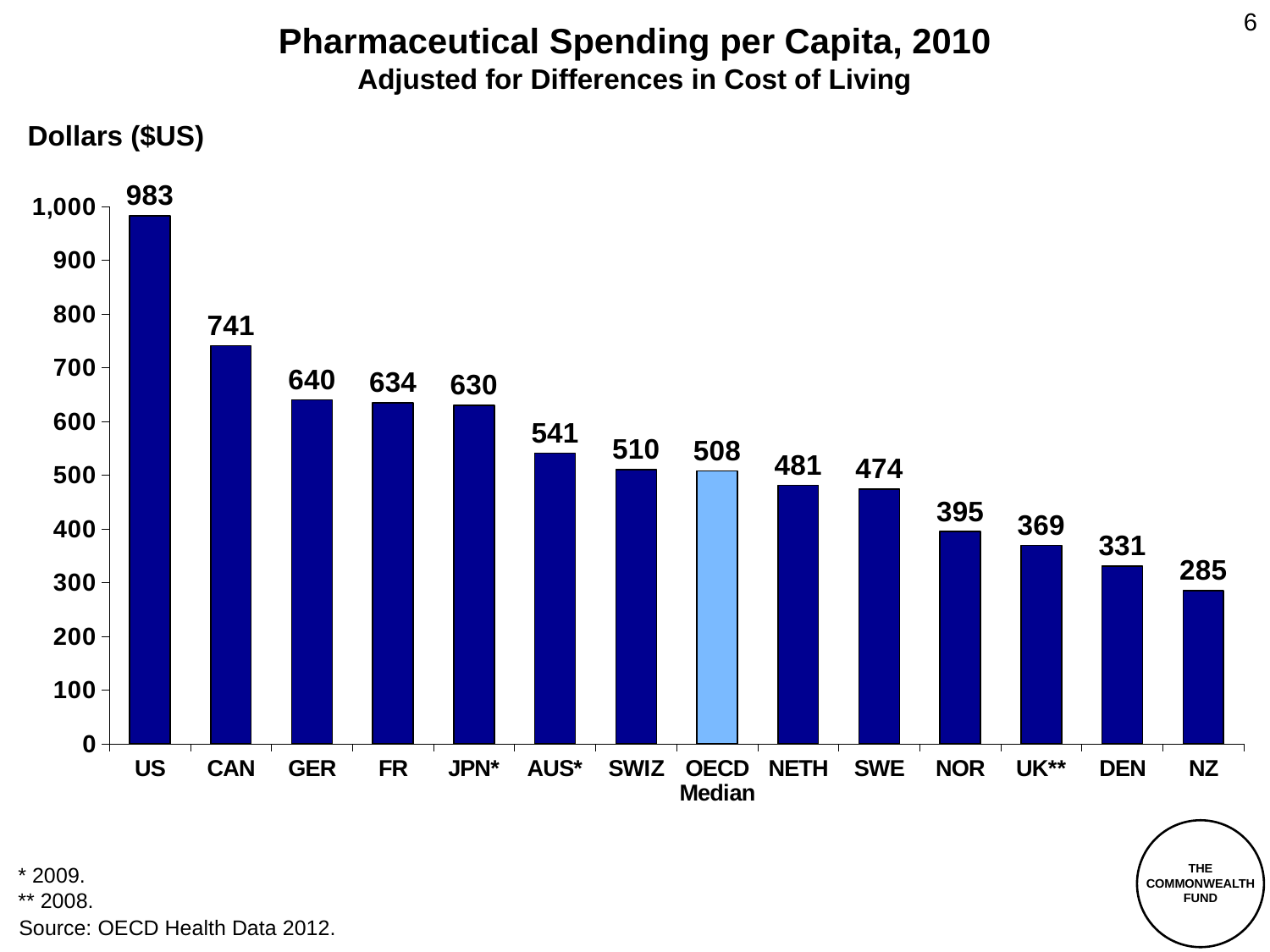
Is the value for DEN greater or less than 400? less Which country has the highest pharmaceutical spending per capita? US What is the pharmaceutical spending per capita for the US? 983 How many bars are shown in the chart? 14 What is the difference between the SWIZ value and the OECD Median? 2 What type of chart is shown on the slide? Bar chart What is the value shown for the OECD Median? 508 What is the pharmaceutical spending per capita for NOR? 395 Which country has the lowest pharmaceutical spending per capita? NZ Which bar is shown in a different (light blue) colour from the others? OECD Median What is the difference between the US value and the CAN value? 242 Which has a higher value, GER or FR? GER